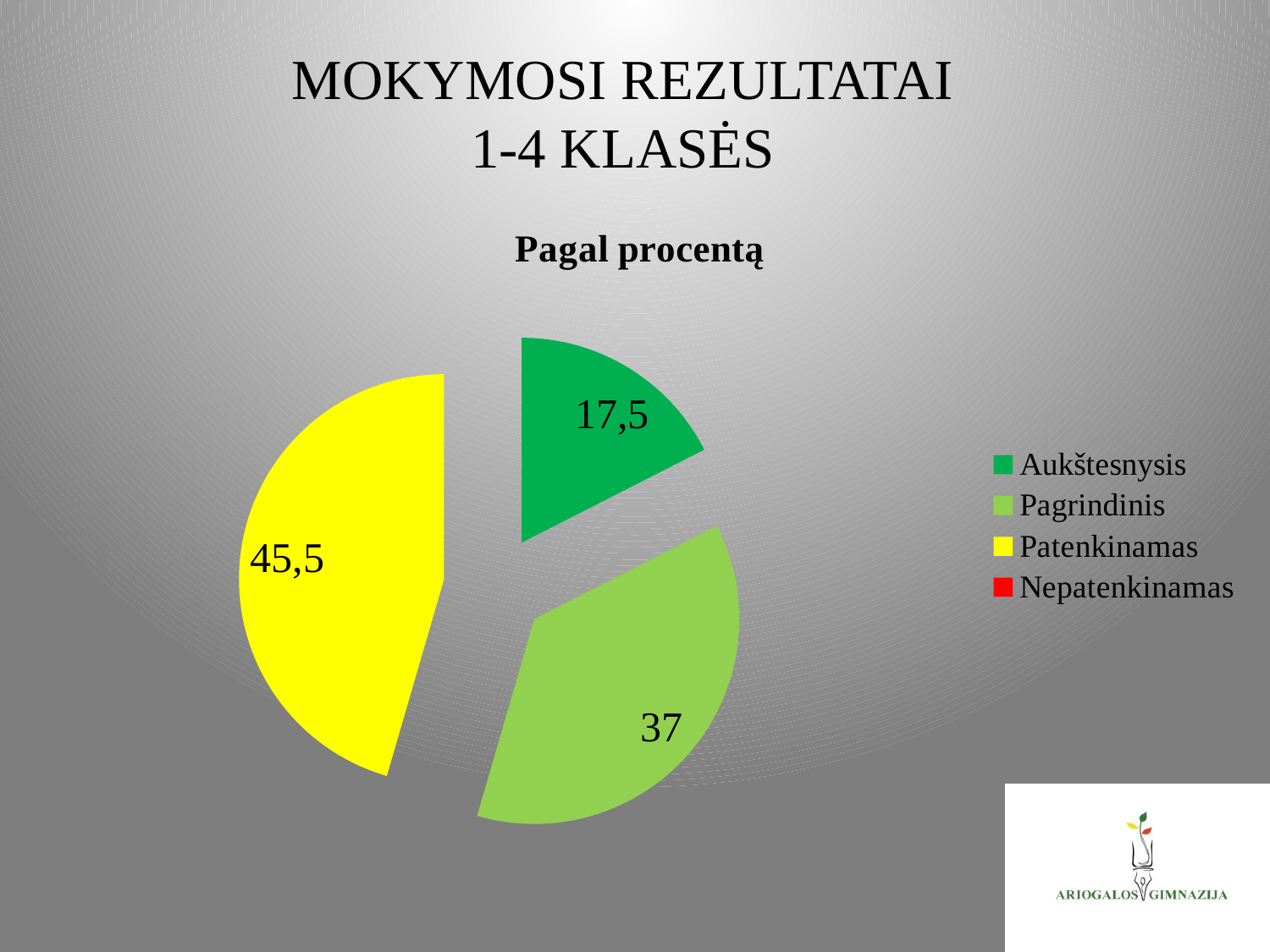
What is the value for Pagrindinis? 37 What is the difference between the values for Patenkinamas and Aukštesnysis? 28 What is the value for Patenkinamas? 45,5 What is the title of the chart? Pagal procentą What is the value for Aukštesnysis? 17,5 What colour is the Patenkinamas slice? yellow Which is larger, the value for Pagrindinis or the value for Aukštesnysis? Pagrindinis How many entries does the legend list? 4 What is the difference between the values for Patenkinamas and Pagrindinis? 8,5 Which of the visible slices is the smallest? Aukštesnysis What type of chart is shown on the slide? pie chart Which category has the largest slice of the pie? Patenkinamas